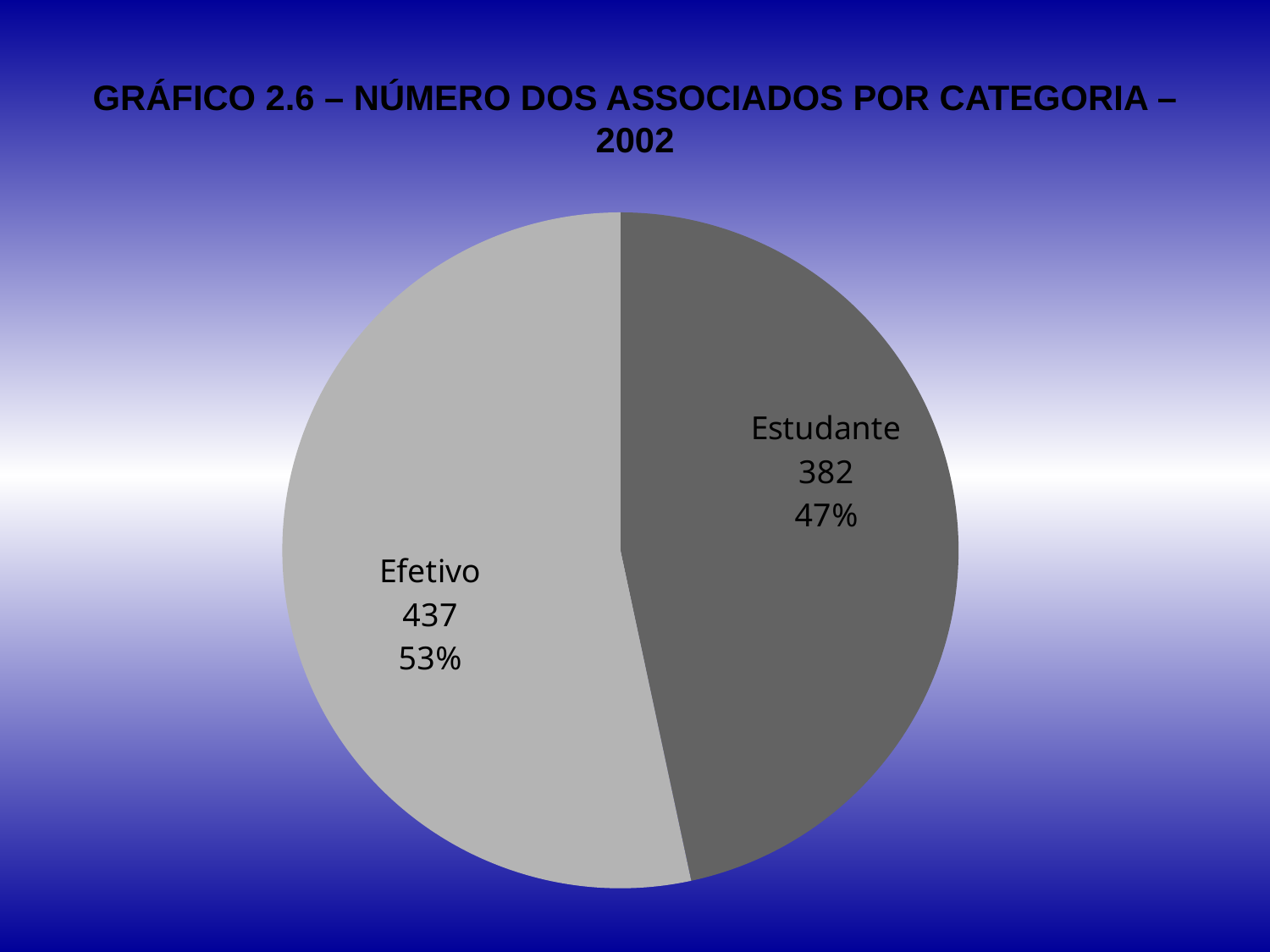
What is the difference between the values for Efetivo and Estudante? 55 What share of the pie does Estudante represent? 47% What type of chart is shown on the slide? pie chart What is the title of the chart? GRÁFICO 2.6 – NÚMERO DOS ASSOCIADOS POR CATEGORIA – 2002 What is the value for Estudante? 382 What is the value for Efetivo? 437 What is the total of the two categories shown in the pie chart? 819 How many categories does the pie chart show? 2 Which category has the smallest slice? Estudante Which category has the largest slice? Efetivo Which is larger, the value for Efetivo or the value for Estudante? Efetivo What share of the pie does Efetivo represent? 53%